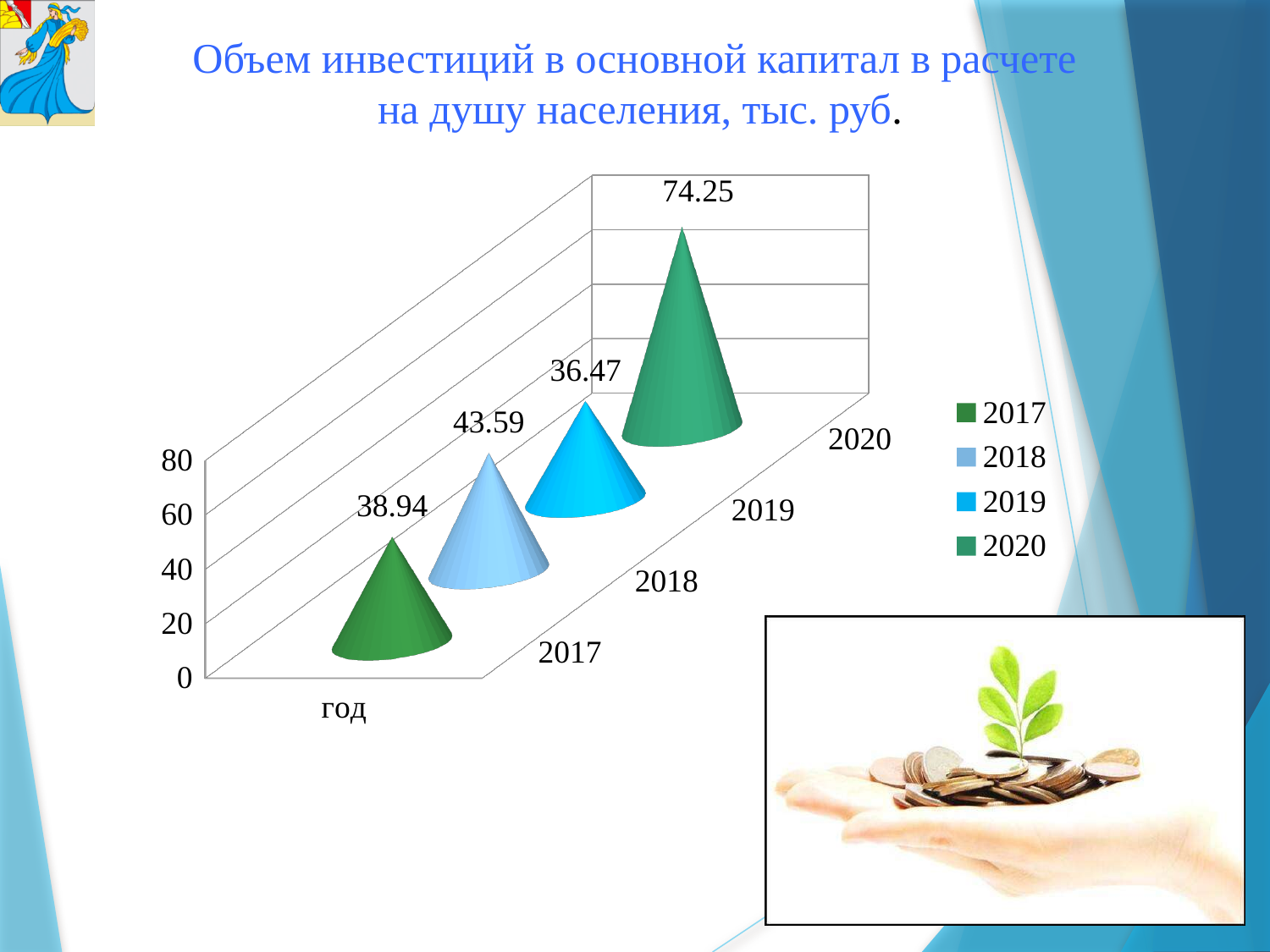
Is the value for 2020 greater or less than 60? greater What is the value for 2019? 36.47 What is the value for 2017? 38.94 How many years are plotted on the chart? 4 What is the title of the chart? Объем инвестиций в основной капитал в расчете на душу населения, тыс. руб. What is the value for 2018? 43.59 What is the value for 2020? 74.25 Which year has the highest value? 2020 Which year has the lowest value? 2019 How many entries does the legend list? 4 Which is larger, the value for 2018 or the value for 2019? 2018 What is the difference between the values for 2020 and 2017? 35.31